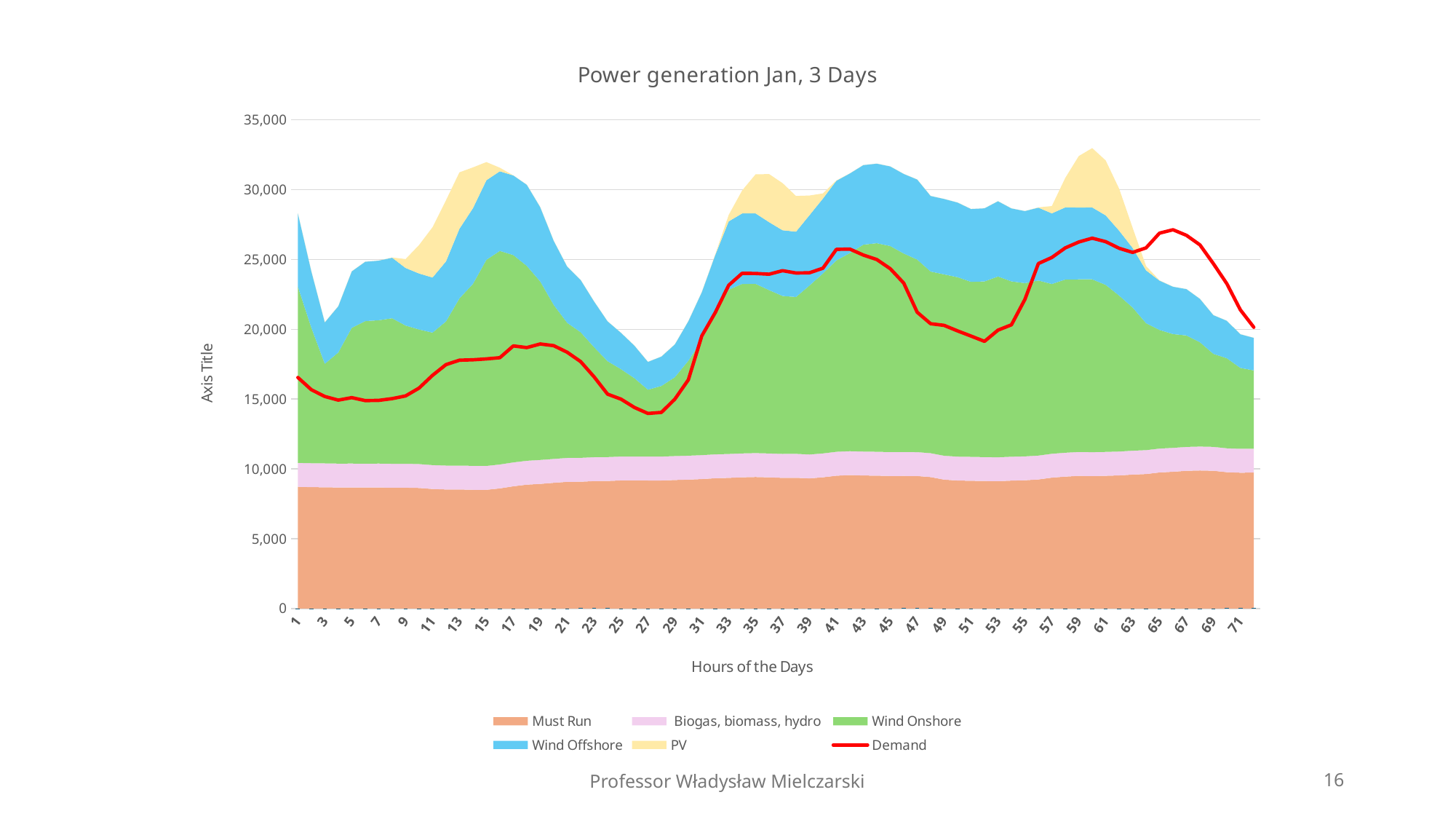
Is the Demand value at hour 1 greater or less than 15,000? greater Is the total stacked generation at hour 27 greater or less than 20,000? less What is the x-axis title of the chart? Hours of the Days Which is larger, the Demand value at hour 67 or at hour 27? Hour 67 Is the total stacked generation at hour 15 greater or less than 30,000? greater What is the title of the chart? Power generation Jan, 3 Days Does the Demand line rise or fall between hour 27 and hour 41? Rise What kind of chart is shown on the slide? Stacked area chart with a line series How many series does the legend list? 6